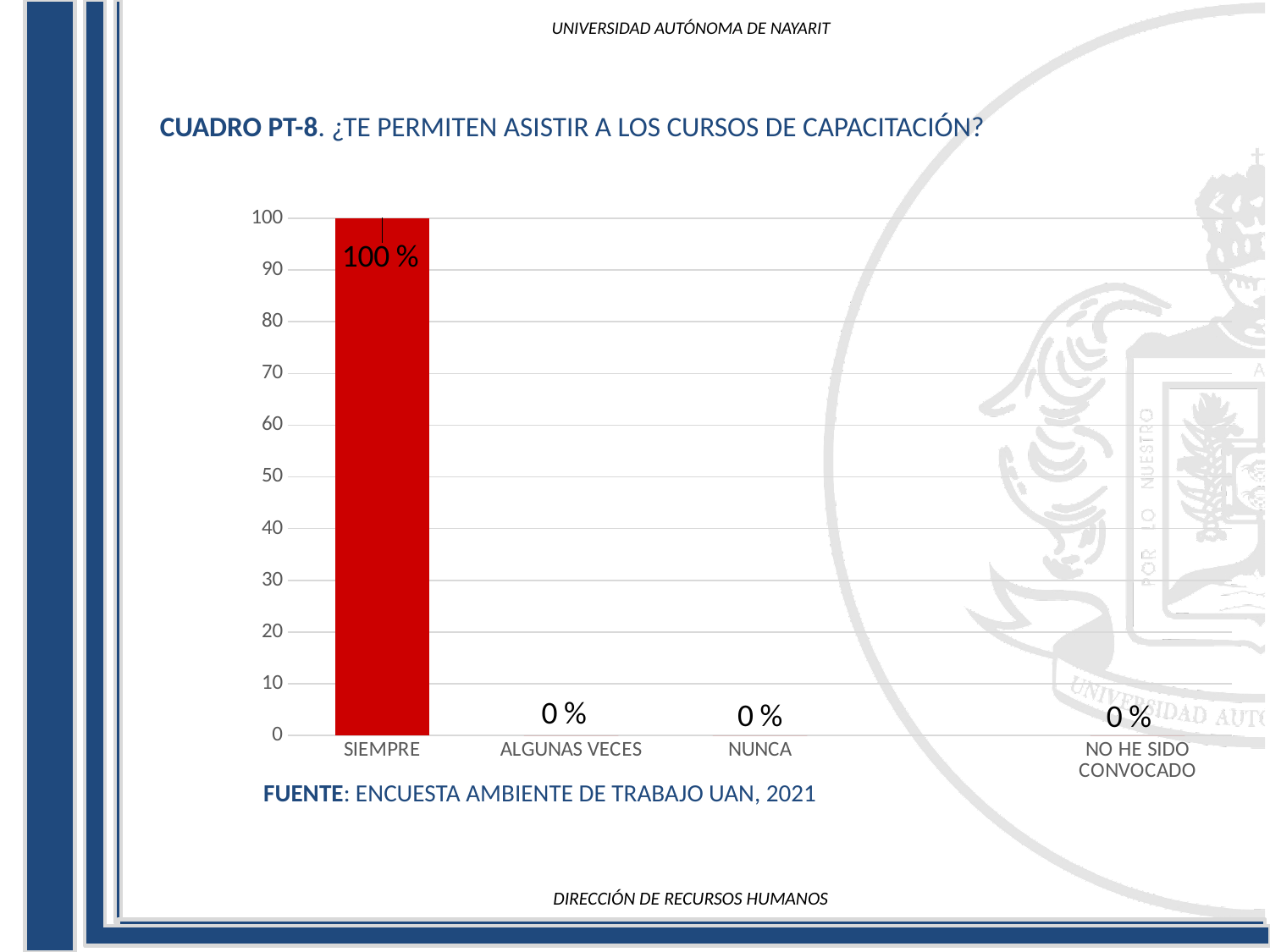
Is the value for SIEMPRE greater or less than 50? greater What is the value for NUNCA? 0 % Which is larger, the value for SIEMPRE or the value for ALGUNAS VECES? SIEMPRE What is the title of the chart (CUADRO PT-8)? ¿TE PERMITEN ASISTIR A LOS CURSOS DE CAPACITACIÓN? Which category has the highest value? SIEMPRE What colour is the bar for SIEMPRE? red What is the value for SIEMPRE? 100 % What kind of chart is shown on the slide? bar chart What is the value for ALGUNAS VECES? 0 % How many categories are shown on the x axis? 4 What is the value for NO HE SIDO CONVOCADO? 0 % What is the difference between the values for SIEMPRE and NUNCA? 100 %